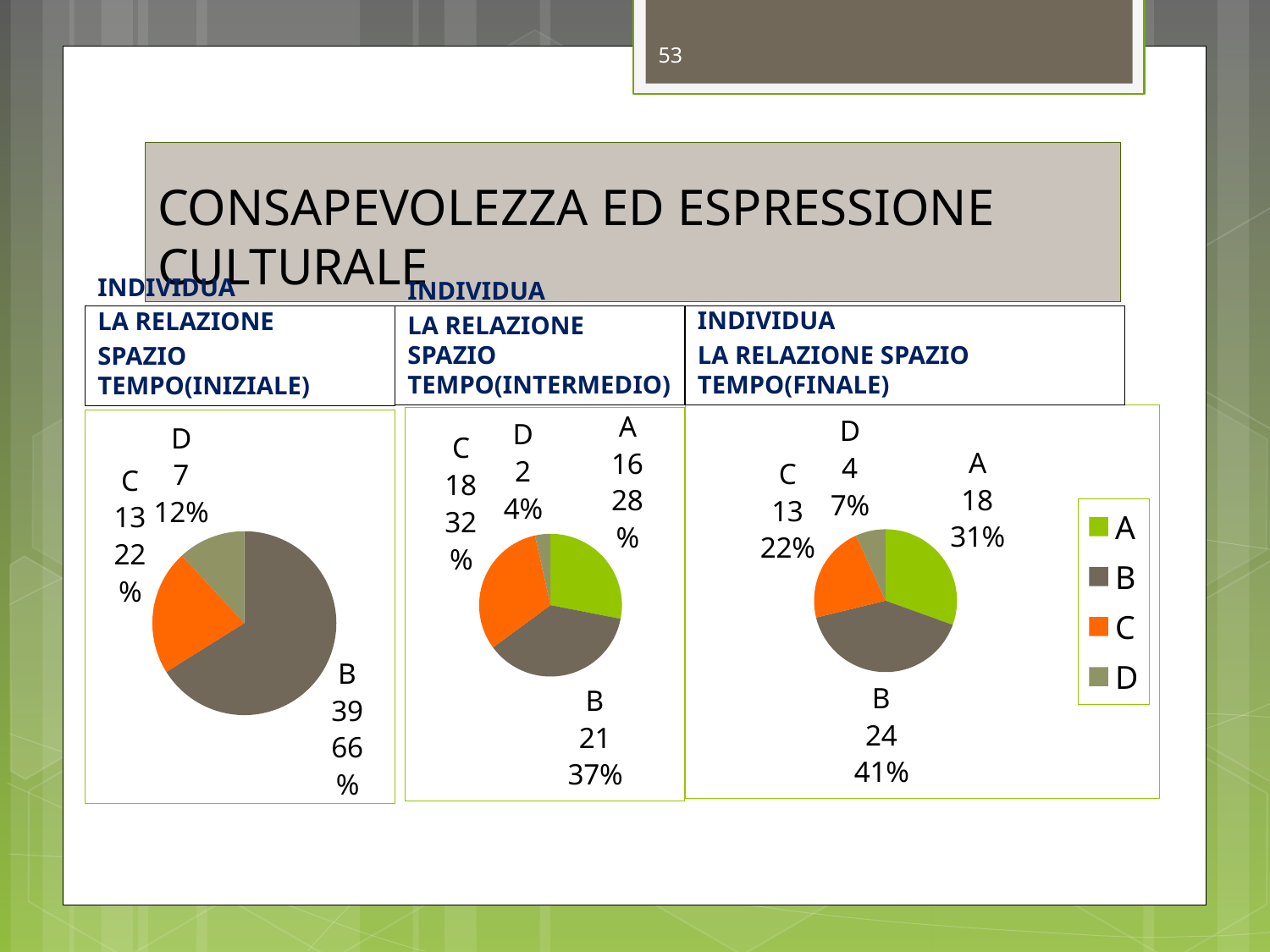
In the INIZIALE pie chart, what percentage share does category C have? 22% How many categories does the legend on the right list? 4 In the FINALE pie chart, which is larger, the count for A or the count for C? A In the FINALE pie chart, what percentage share does category A have? 31% In the INTERMEDIO pie chart, what is the count for category A? 16 In the INIZIALE pie chart, what is the count for category B? 39 What type of chart is used for the INIZIALE, INTERMEDIO and FINALE data? Pie chart In the FINALE pie chart, what is the count for category B? 24 In the INTERMEDIO pie chart, what is the difference between the counts for B and C? 3 In the INIZIALE pie chart, which category has the smallest slice? D In the INTERMEDIO pie chart, which category has the largest slice? B In the INTERMEDIO pie chart, what percentage share does category D have? 4%